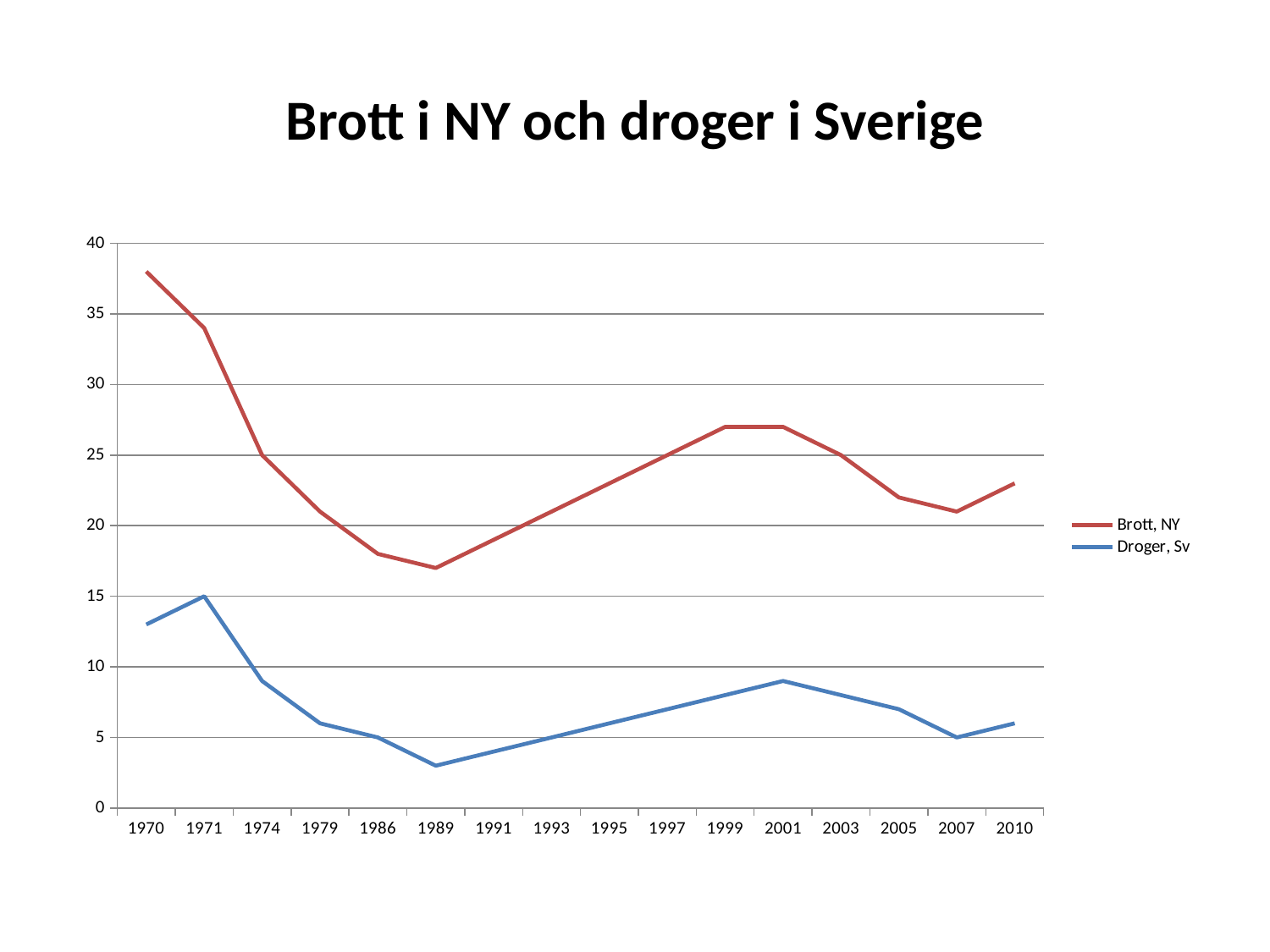
Is the value for Droger, Sv in 1989 greater or less than 5? less How many years are shown on the x axis? 16 In which year is Droger, Sv lowest? 1989 Which series has the larger value in 1970, Brott, NY or Droger, Sv? Brott, NY Is the value for Brott, NY in 1970 greater or less than 35? greater Does Brott, NY rise or fall from 1970 to 1989? fall What kind of chart is shown on the slide? line chart What is the value for Droger, Sv in 1971? 15 What is the value for Droger, Sv in 2007? 5 What is the value for Brott, NY in 1974? 25 In which year is Brott, NY highest? 1970 How many series does the legend list? 2